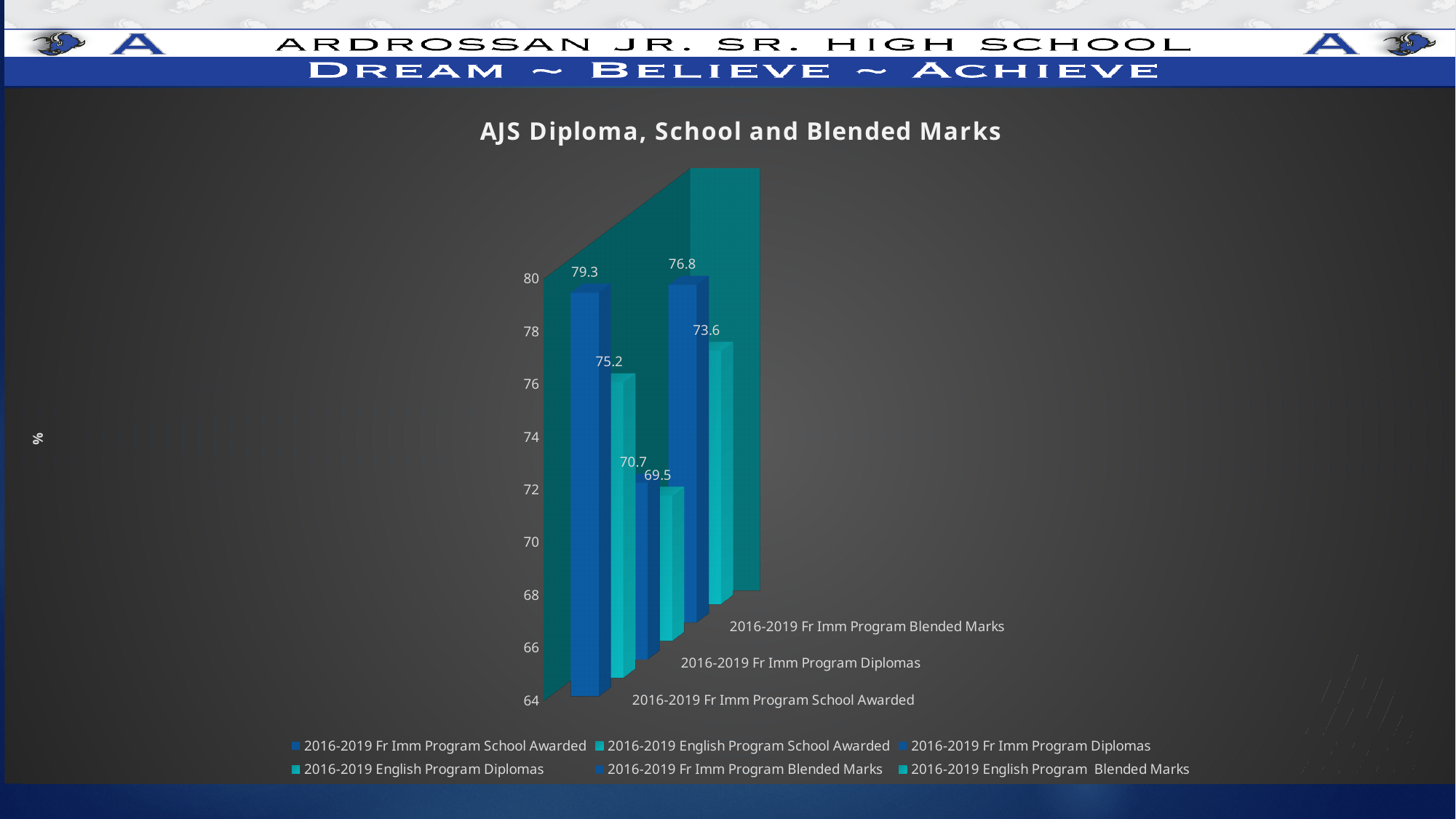
What is the value for 2016-2019 Fr Imm Program Blended Marks? 76.8 What is the value for 2016-2019 Fr Imm Program Diplomas? 70.7 What is the value for 2016-2019 English Program School Awarded? 75.2 What is the value for 2016-2019 English Program Diplomas? 69.5 What is the value for 2016-2019 Fr Imm Program School Awarded? 79.3 What is the value for 2016-2019 English Program Blended Marks? 73.6 What is the title of the chart? AJS Diploma, School and Blended Marks Which series has the lowest value on the chart? 2016-2019 English Program Diplomas Which is larger: 2016-2019 Fr Imm Program Blended Marks or 2016-2019 English Program Blended Marks? 2016-2019 Fr Imm Program Blended Marks What is the difference between the 2016-2019 Fr Imm Program School Awarded value and the 2016-2019 English Program School Awarded value? 4.1 Which series has the highest value on the chart? 2016-2019 Fr Imm Program School Awarded How many series does the legend list? 6